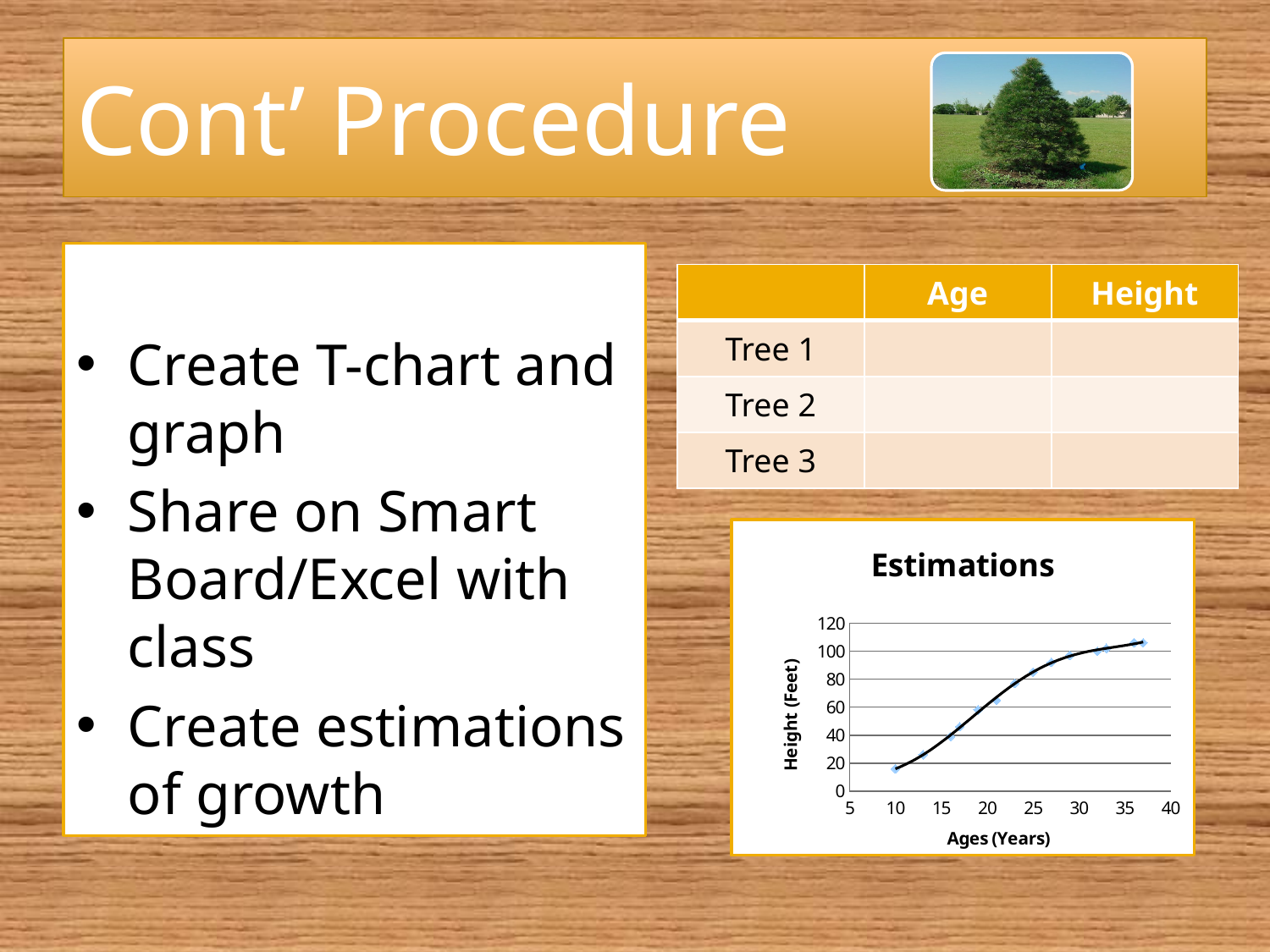
What is the label of the vertical axis of the "Estimations" chart? Height (Feet) In the "Estimations" chart, at which end of the age range is the height lowest, the youngest or the oldest age? youngest In the "Estimations" chart, is the height at age 20 greater or less than 40 feet? greater What is the title of the chart on the slide? Estimations What kind of chart is the "Estimations" chart? scatter chart with a smooth line In the "Estimations" chart, is the height at the oldest age plotted greater or less than 100 feet? greater In the "Estimations" chart, is the height at age 15 greater or less than 60 feet? less In the "Estimations" chart, do the heights rise or fall as age increases along the x axis? rise In the "Estimations" chart, which is larger: the height at age 30 or the height at age 15? age 30 What is the highest value shown on the vertical axis of the "Estimations" chart? 120